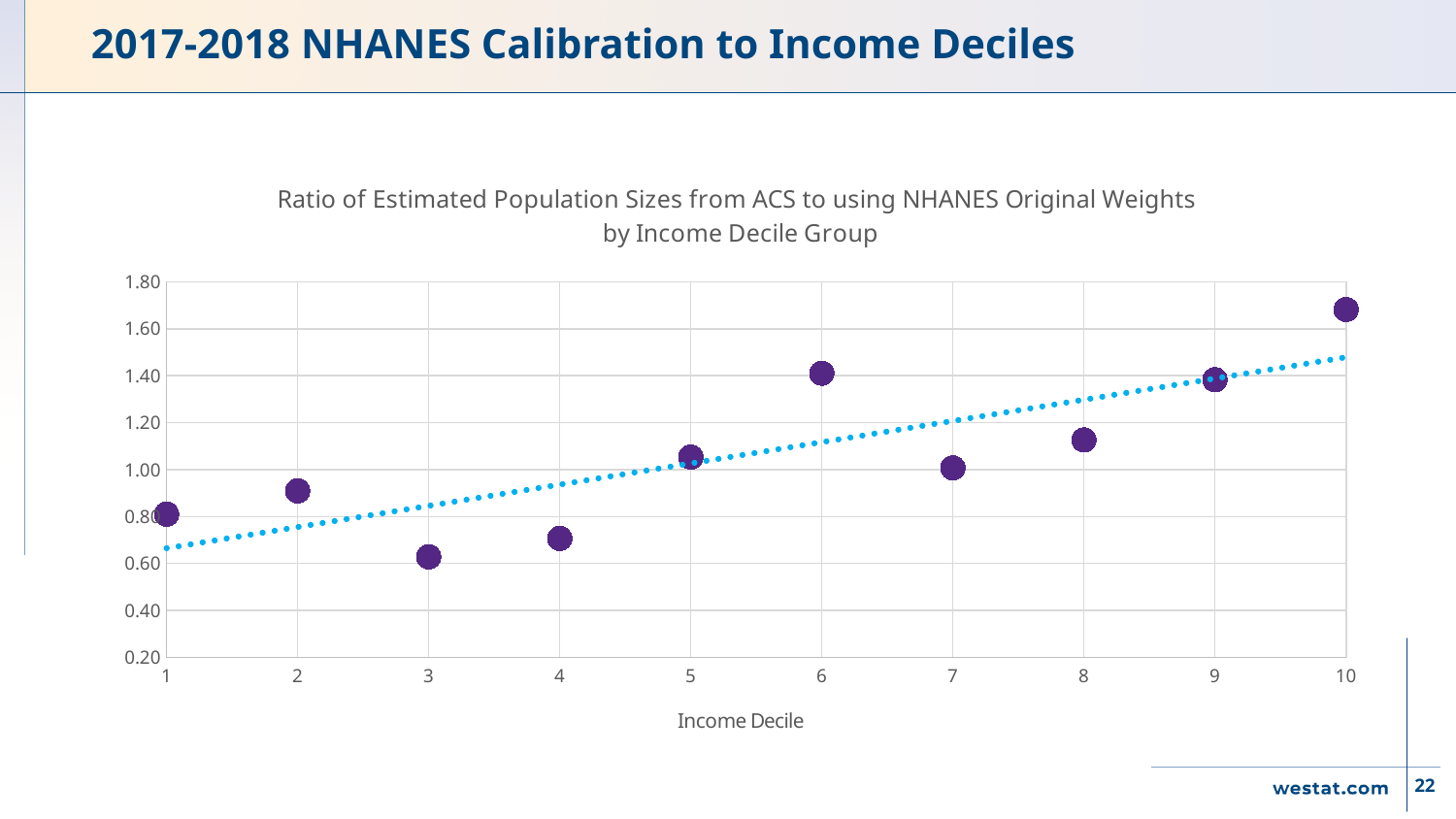
Which income decile has the highest ratio? 10 Does the dotted trend line rise or fall as income decile increases? rise Is the value for income decile 4 greater or less than 1.00? less Which has the larger ratio, income decile 6 or income decile 7? 6 Is the value for income decile 6 greater or less than 1.20? greater How many income decile points are plotted on the chart? 10 What kind of chart is shown on the slide? scatter plot Which income decile has the lowest ratio? 3 Is the value for income decile 10 greater or less than 1.60? greater What is the label of the x axis? Income Decile Which has the larger ratio, income decile 2 or income decile 3? 2